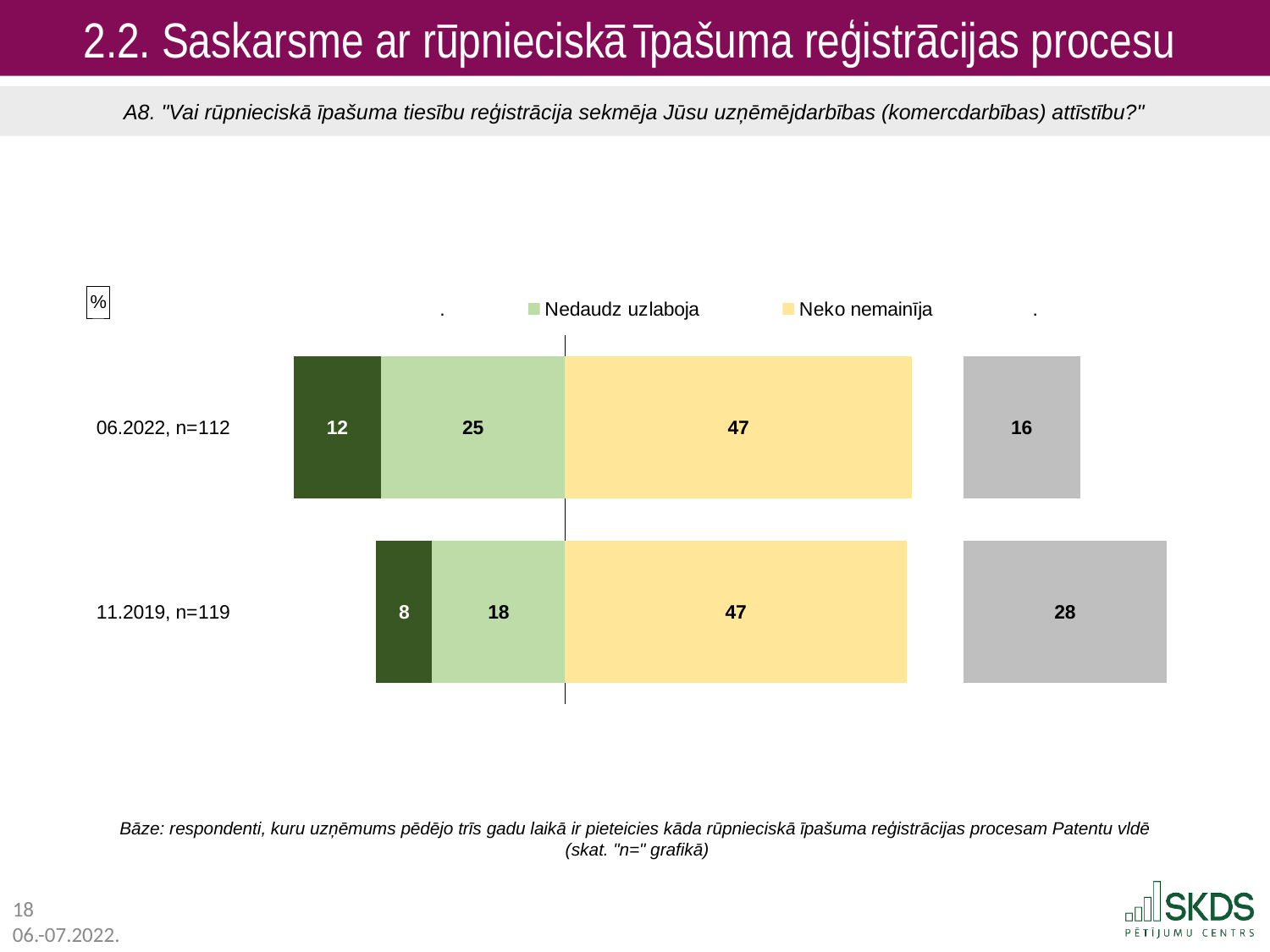
What type of chart is shown on the slide? stacked bar chart What is the value of the "Nedaudz uzlaboja" segment for 06.2022, n=112? 25 Are the "Neko nemainīja" values for 06.2022 and 11.2019 the same or different? the same How many bars (survey waves) are shown in the chart? 2 What is the total of all segments in the 06.2022, n=112 bar? 100 Which year has the larger "Nedaudz uzlaboja" value, 06.2022 or 11.2019? 06.2022 What is the value of the "Neko nemainīja" segment for 11.2019, n=119? 47 What is the difference between the grey segment values for 11.2019 and 06.2022? 12 What is the value of the "Nedaudz uzlaboja" segment for 11.2019, n=119? 18 By how much does the "Nedaudz uzlaboja" value for 06.2022 exceed that for 11.2019? 7 What is the value of the grey rightmost segment for 11.2019, n=119? 28 What is the value of the dark green leftmost segment for 06.2022, n=112? 12